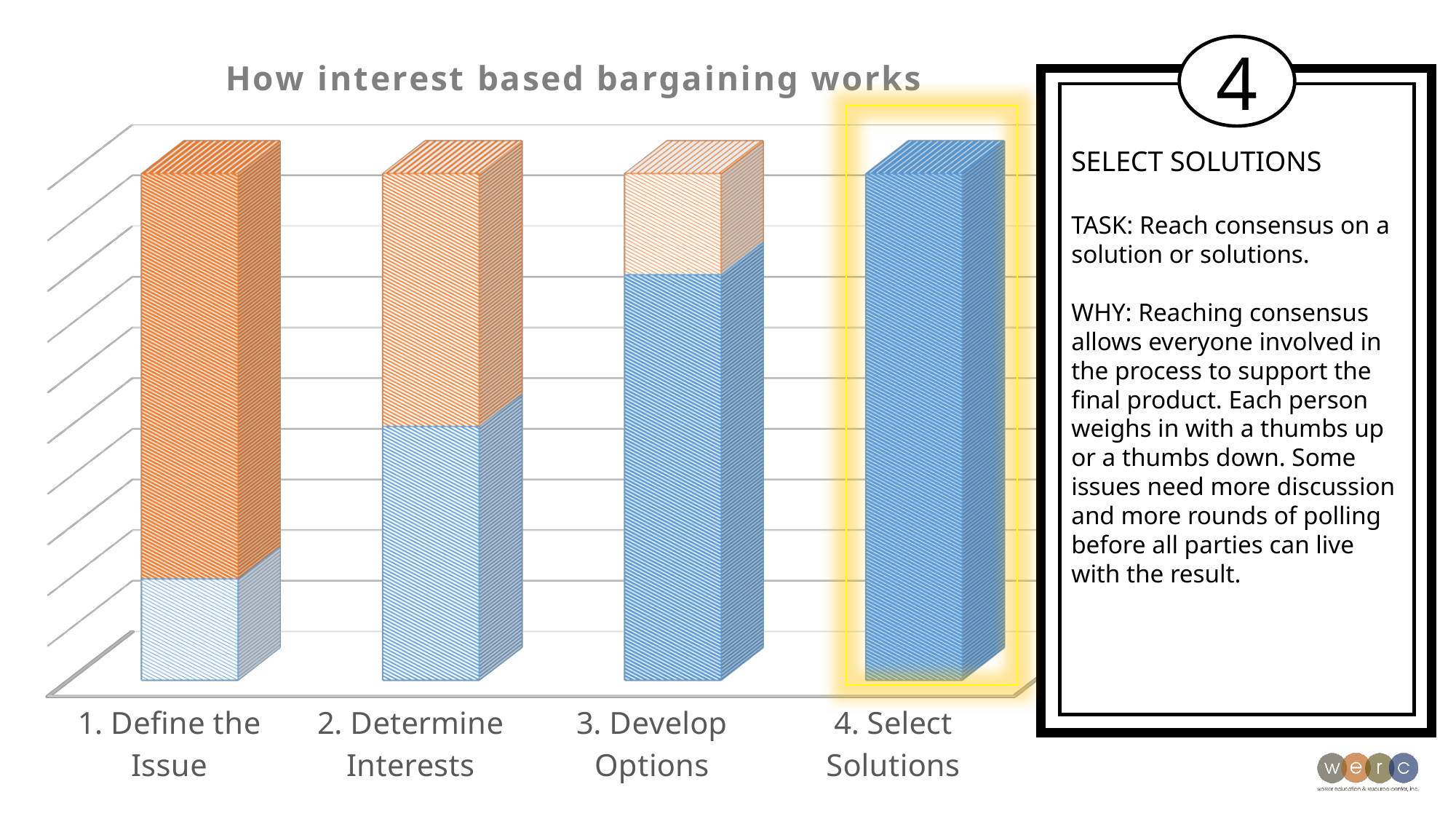
Does the blue segment rise or fall moving from left to right across the categories? Rises What is the title of the chart? How interest based bargaining works Which category's bar is highlighted with a yellow outline? 4. Select Solutions Which category has the largest blue segment? 4. Select Solutions In the bar for 1. Define the Issue, which segment is larger, the orange or the blue? Orange What kind of chart is shown on the slide? Stacked bar chart How many categories are shown along the x axis of the chart? 4 Which category has the largest orange segment? 1. Define the Issue Does the orange segment rise or fall moving from left to right across the categories? Falls Which category has the smallest blue segment? 1. Define the Issue Which category has no orange segment at all? 4. Select Solutions In the bar for 3. Develop Options, which segment is larger, the orange or the blue? Blue